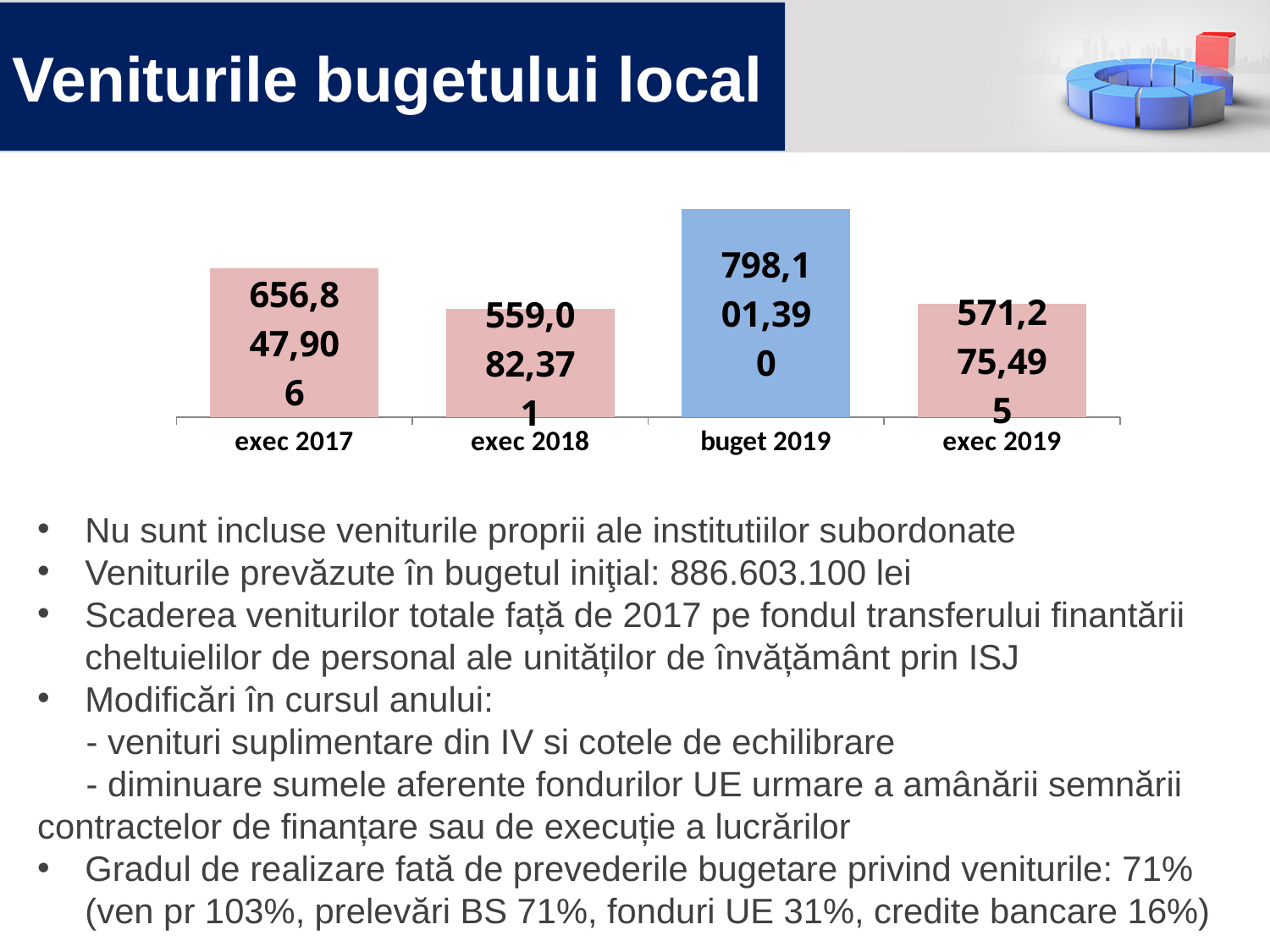
What is the difference between buget 2019 and exec 2019? 226,825,895 How many categories are shown in the chart? 4 Which is larger, exec 2017 or exec 2019? exec 2017 What is the value for exec 2017? 656,847,906 What kind of chart is shown on the slide? bar chart Which category has the highest value? buget 2019 What is the value for buget 2019? 798,101,390 What is the difference between exec 2017 and exec 2018? 97,765,535 Which bar is coloured blue rather than pink? buget 2019 What is the value for exec 2019? 571,275,495 Which category has the lowest value? exec 2018 What is the value for exec 2018? 559,082,371